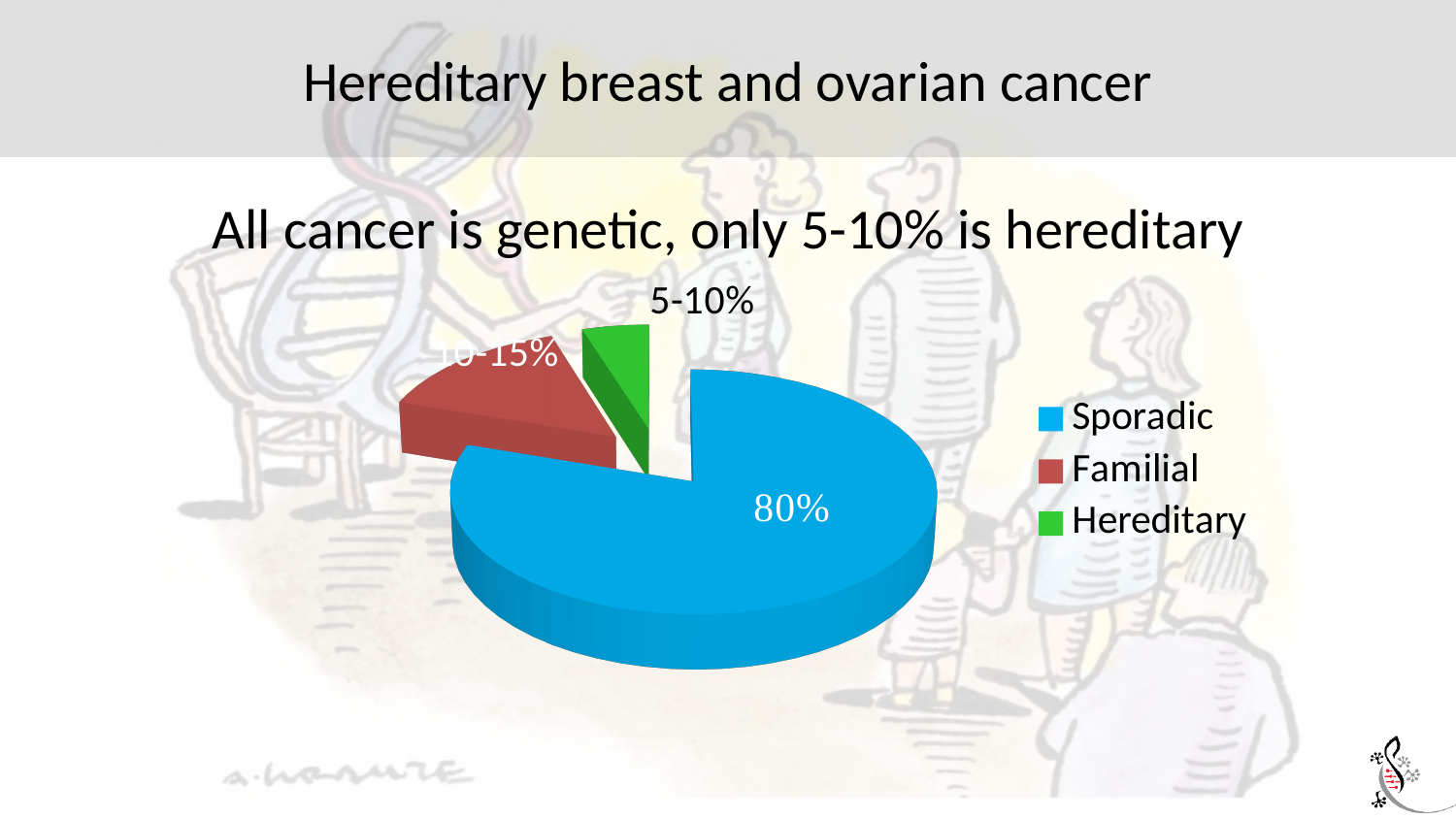
Which category has the largest slice of the pie? Sporadic What kind of chart is shown on the slide? pie chart What percentage is shown for the Sporadic slice? 80% What colour is the Sporadic slice? blue What share of the pie does the Sporadic slice represent? 80% What percentage is shown for the Hereditary slice? 5-10% What percentage is shown for the Familial slice? 10-15% Which category has the smallest slice of the pie? Hereditary How many slices does the pie chart have? 3 Which legend entry is shown in green? Hereditary Which slice is larger, Familial or Hereditary? Familial How many entries does the legend list? 3